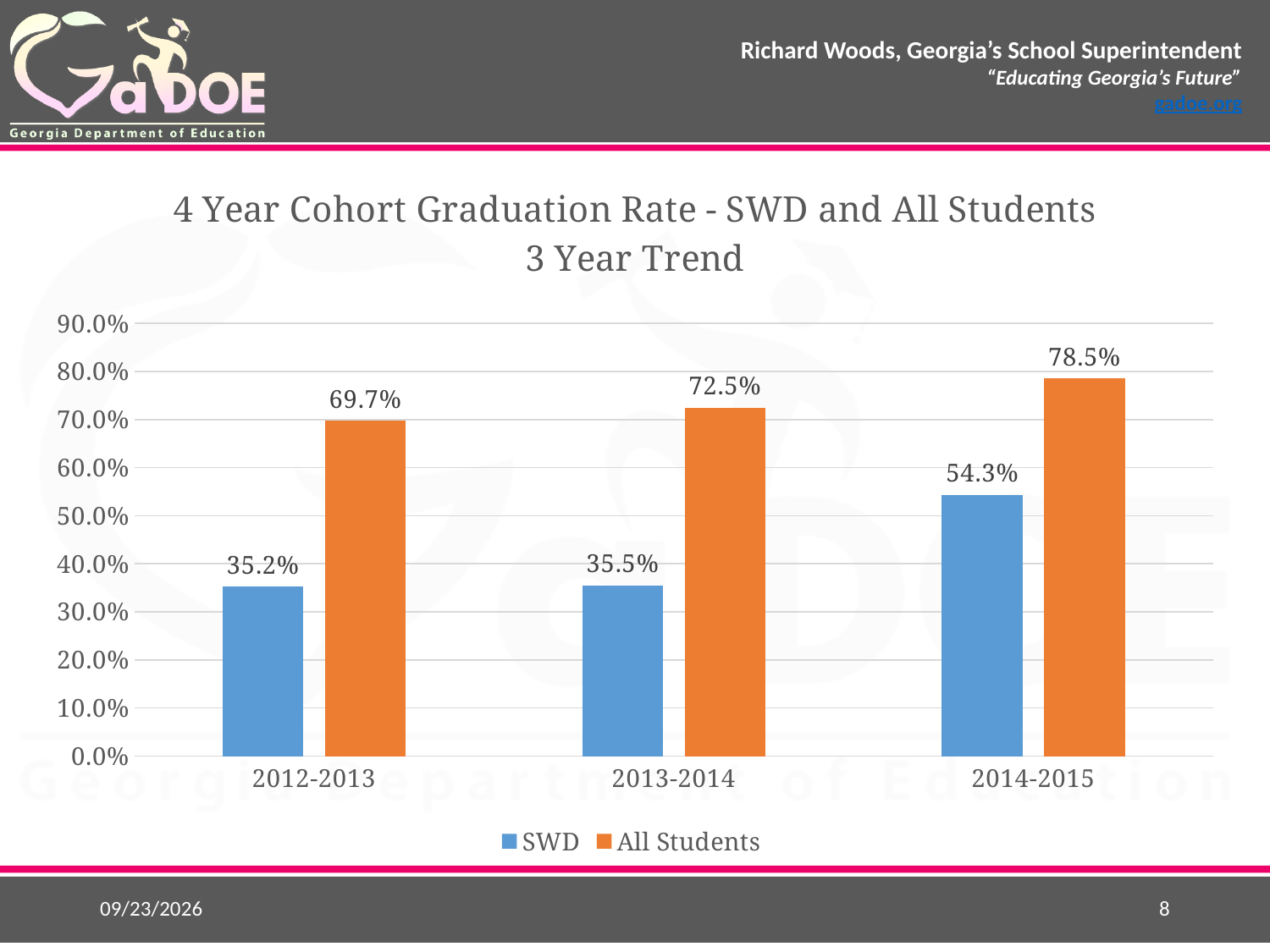
What is the SWD graduation rate for 2014-2015? 54.3% What kind of chart is shown on the slide? Bar chart How many series does the legend list? 2 Which year has the highest All Students graduation rate? 2014-2015 Which is larger: the SWD rate in 2014-2015 or the All Students rate in 2012-2013? All Students rate in 2012-2013 How many year categories are shown on the x axis? 3 What is the difference between the All Students and SWD rates in 2014-2015? 24.2% What is the SWD value for 2013-2014? 35.5% What is the difference between the All Students rates for 2013-2014 and 2012-2013? 2.8% What is the All Students graduation rate for 2012-2013? 69.7% Which year has the lowest SWD graduation rate? 2012-2013 Do the All Students values rise or fall from 2012-2013 to 2014-2015? Rise